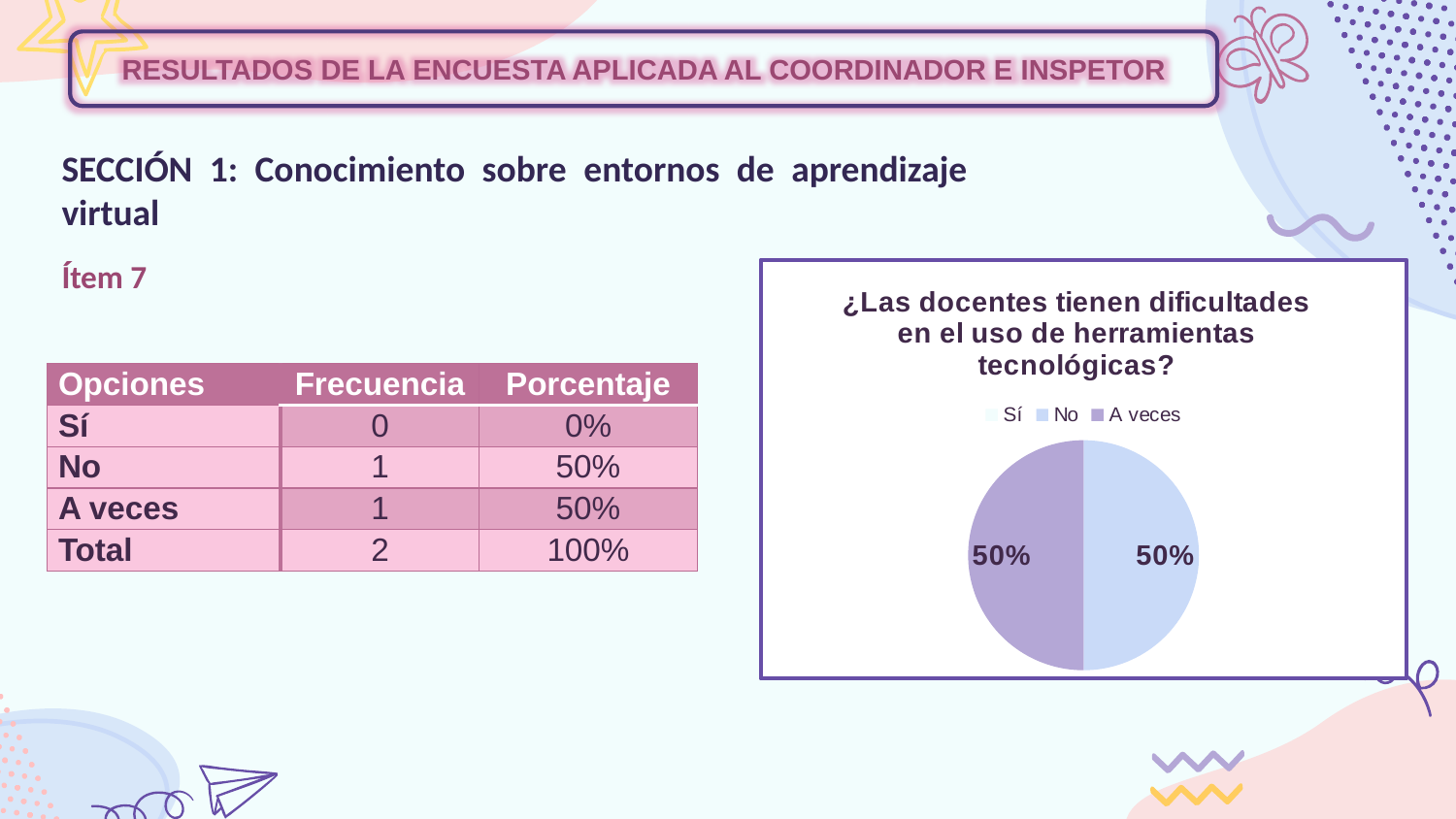
What is the combined share of the "No" and "A veces" slices? 100% Is the "No" slice larger or smaller than the "A veces" slice, or are they equal? equal How many slices with a visible share are shown in the pie chart? 2 How many entries does the legend of the pie chart list? 3 What is the title of the pie chart? ¿Las docentes tienen dificultades en el uso de herramientas tecnológicas? What are the legend entries of the pie chart? Sí, No, A veces What is the difference between the share of "No" and the share of "A veces" in the pie chart? 0% What kind of chart is shown on the slide? pie chart What share of the pie does the "No" slice represent? 50% What share of the pie does the "A veces" slice represent? 50% Which legend category has no visible slice in the pie chart? Sí